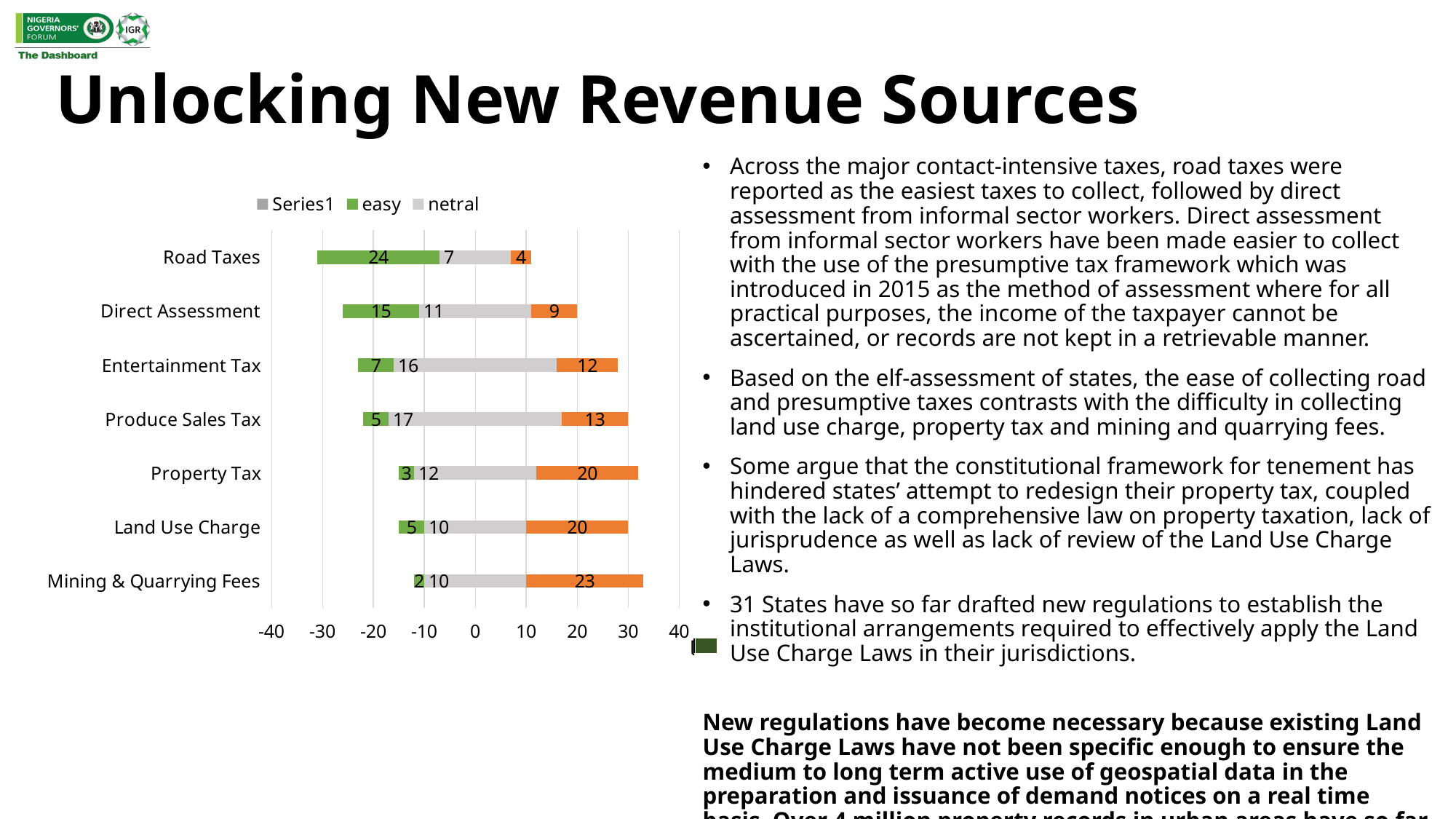
Which has a larger 'easy' value, Entertainment Tax or Produce Sales Tax? Entertainment Tax Which category has the highest 'netral' value? Produce Sales Tax Which category has the lowest 'easy' value? Mining & Quarrying Fees How many series does the legend list? 3 What kind of chart is shown on the slide? Bar chart What is the 'easy' value for Road Taxes? 24 How many categories are shown on the chart? 7 What is the total of the three labelled segments for Road Taxes? 35 What is the 'netral' value for Produce Sales Tax? 17 What is the orange segment value for Mining & Quarrying Fees? 23 What is the difference between the 'easy' value for Road Taxes and the 'easy' value for Direct Assessment? 9 Which category has the highest 'easy' value? Road Taxes